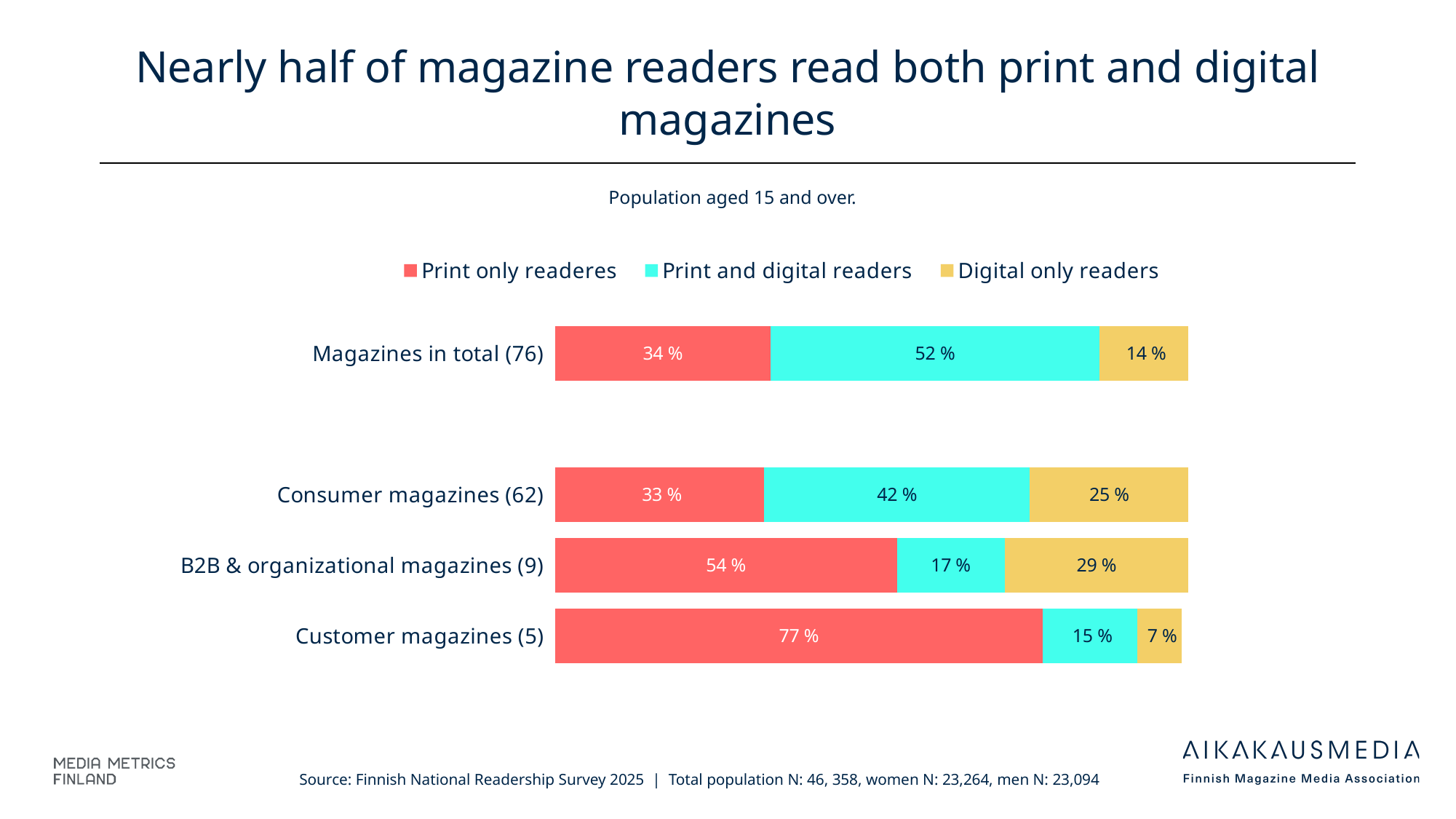
What is the Print only readers value for Customer magazines (5)? 77 % What percentage of Magazines in total (76) readers are Print and digital readers? 52 % Which category has the highest Print only readers share? Customer magazines (5) What is the Print and digital readers value for Consumer magazines (62)? 42 % What kind of chart is shown on the slide? Stacked bar chart Which colour represents Digital only readers in the chart? Yellow Which category has the lowest Digital only readers share? Customer magazines (5) What is the Digital only readers value for B2B & organizational magazines (9)? 29 % Which is larger: the Digital only readers share for Consumer magazines (62) or for Magazines in total (76)? Consumer magazines (62) How many categories are shown on the chart? 4 What is the difference between the Print only readers share for B2B & organizational magazines (9) and Consumer magazines (62)? 21 % How many series does the legend list? 3